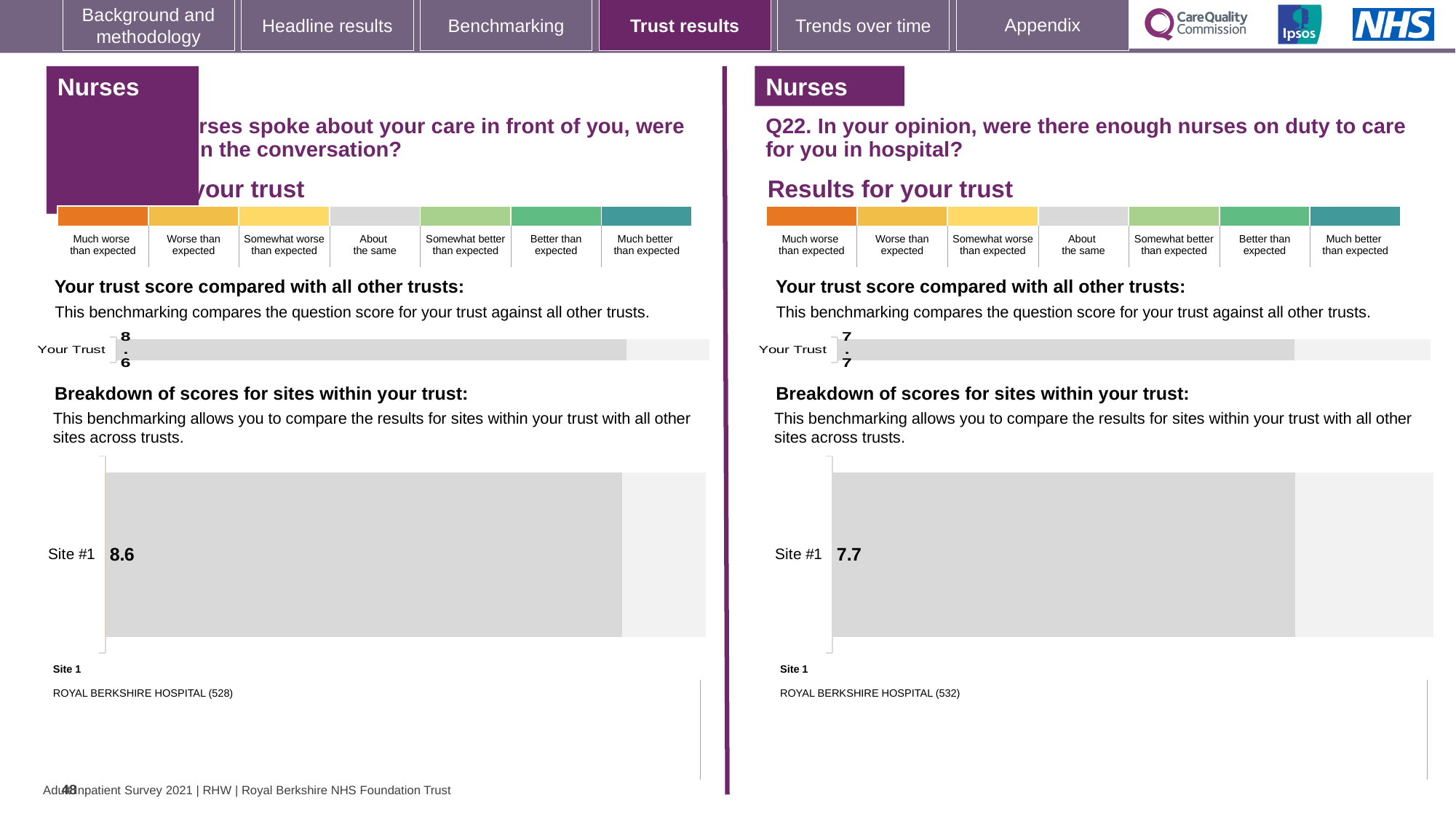
On the right-hand side of the slide (Q22), what is the score shown for Site #1? 7.7 What is the difference between the Your Trust score on the left-hand side of the slide and the Your Trust score on the right-hand side (Q22)? 0.9 On the left-hand side of the slide, which hospital is listed as Site 1? ROYAL BERKSHIRE HOSPITAL (528) On the right-hand side of the slide (Q22), which hospital is listed as Site 1? ROYAL BERKSHIRE HOSPITAL (532) What kind of chart is used to show the Site #1 score on the right-hand side of the slide (Q22)? Bar chart How many sites are shown in the site breakdown chart on the right-hand side of the slide (Q22)? 1 On the left-hand side of the slide, what is the score shown for Site #1? 8.6 Which is larger: the Site #1 score on the left-hand side of the slide or the Site #1 score on the right-hand side (Q22)? Left-hand side (8.6) On the left-hand side of the slide, what is the score shown for Your Trust? 8.6 How many sites are shown in the site breakdown chart on the left-hand side of the slide? 1 On the right-hand side of the slide (Q22), what is the score shown for Your Trust? 7.7 On the right-hand side of the slide (Q22), is the Your Trust score equal to the Site #1 score? Yes